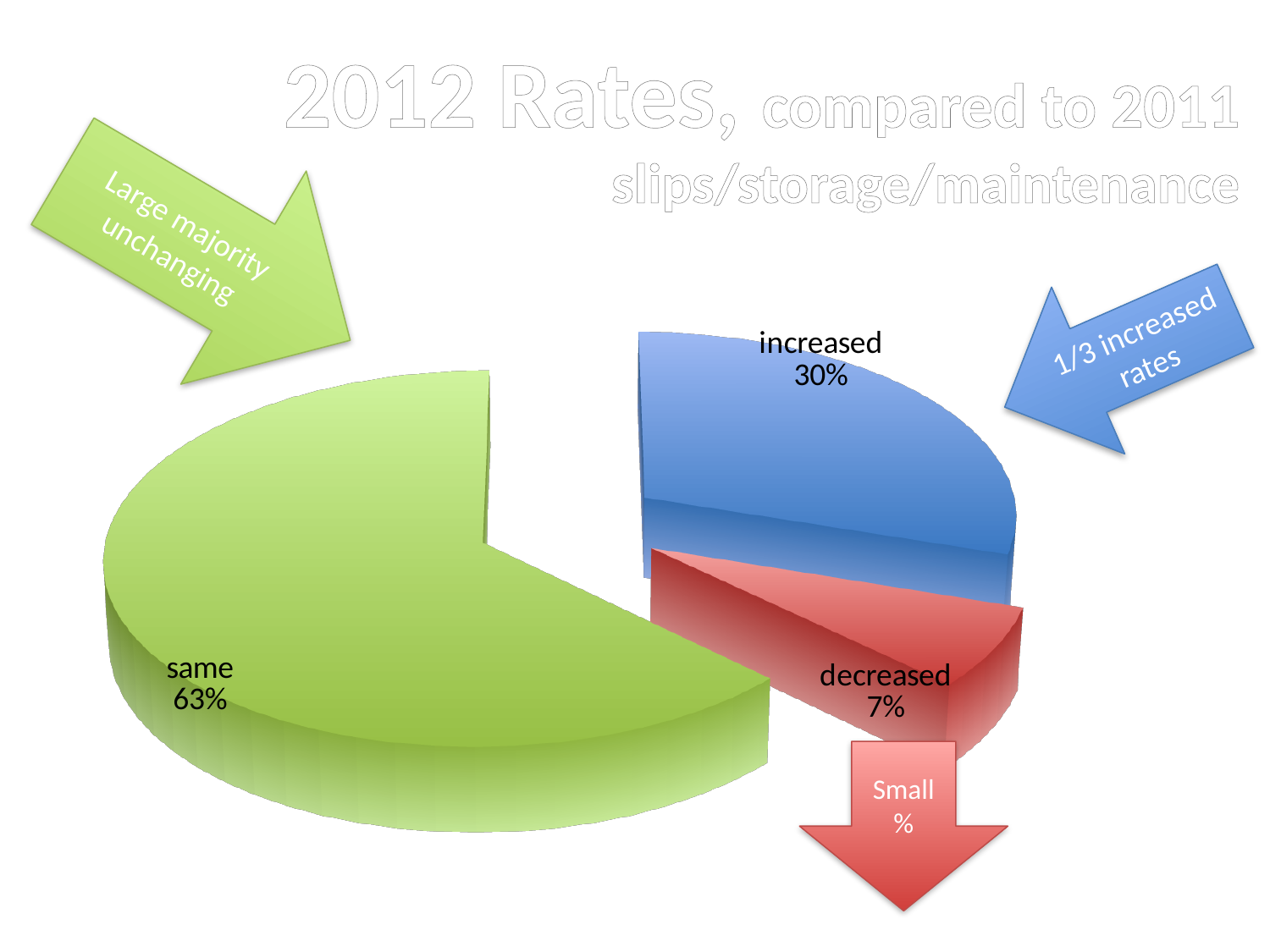
What is the difference in percentage points between the 'increased' slice and the 'decreased' slice? 23 What is the title of the slide containing the pie chart? 2012 Rates, compared to 2011 slips/storage/maintenance Which is larger, the 'increased' slice or the 'decreased' slice? increased Which slice of the pie is the smallest? decreased What colour is the 'same' slice of the pie? green What is the difference in percentage points between the 'same' slice and the 'increased' slice? 33 What percentage of rates stayed the same? 63% Which slice of the pie is the largest? same What kind of chart is shown on the slide? pie chart What percentage of rates increased? 30% How many slices does the pie chart have? 3 What percentage of rates decreased? 7%